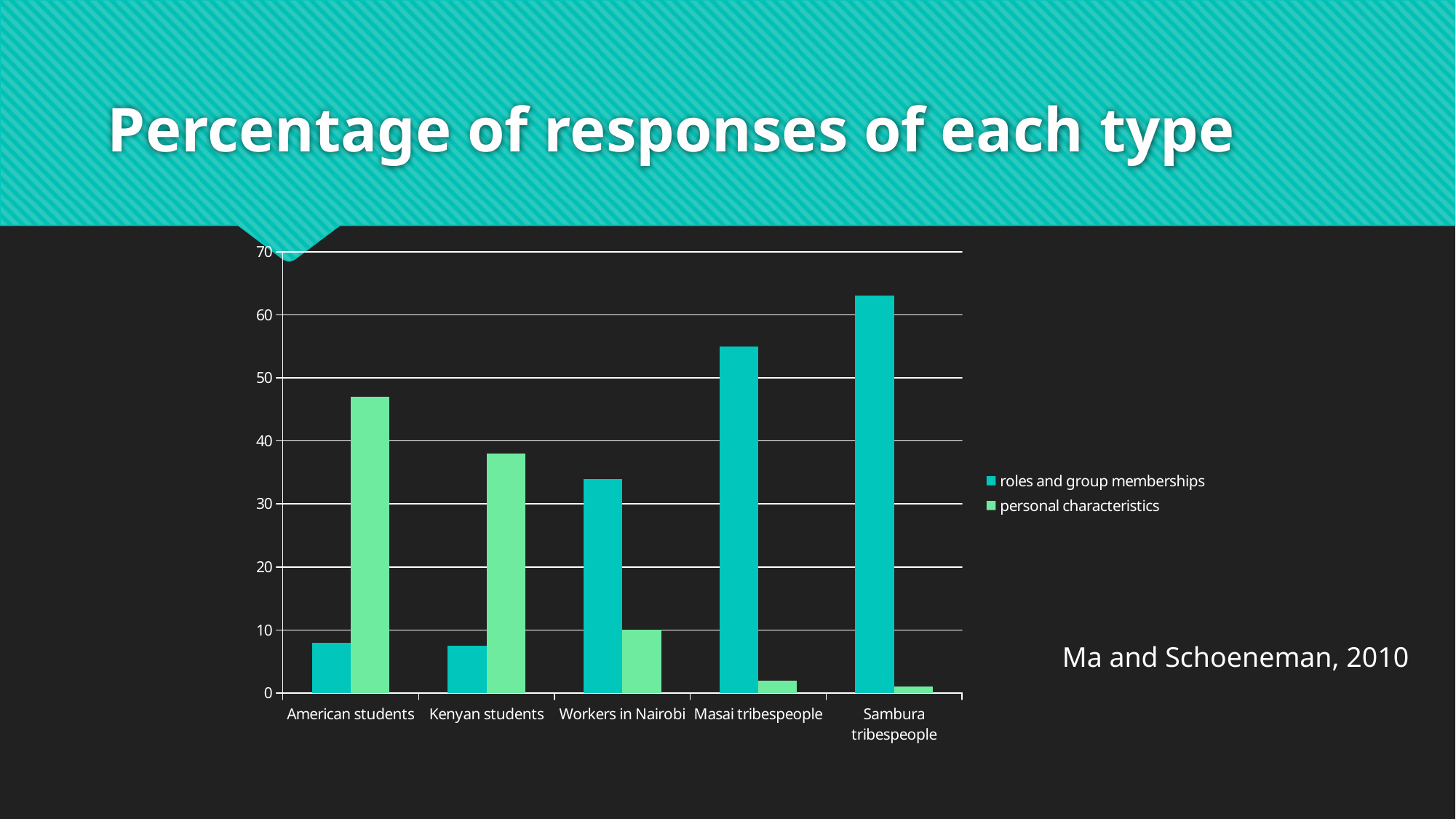
How many series does the legend list? 2 Do the values for roles and group memberships rise or fall from left to right across the categories? rise Is the value for roles and group memberships for Sambura tribespeople greater or less than 60? greater For Kenyan students, which series has the larger value: roles and group memberships or personal characteristics? personal characteristics Which category has the lowest value for personal characteristics? Sambura tribespeople Is the value for roles and group memberships for American students greater or less than 10? less What is the title of the chart? Percentage of responses of each type What kind of chart is shown on the slide? bar chart How many categories are shown on the x axis? 5 Which category has the highest value for personal characteristics? American students Which category has the highest value for roles and group memberships? Sambura tribespeople Is the value for personal characteristics for American students greater or less than 40? greater